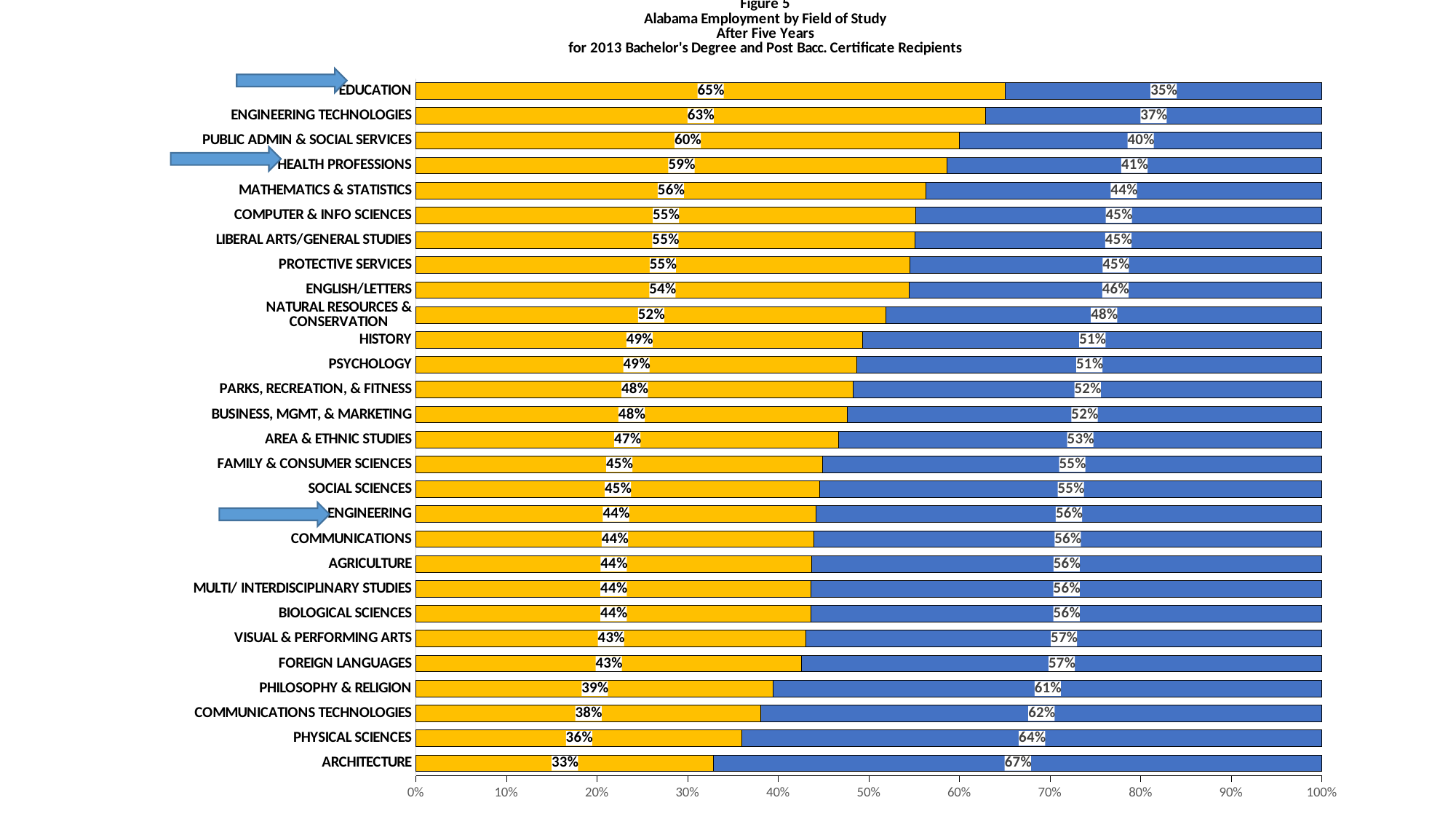
What is the figure number given in the chart title? Figure 5 What is the blue segment value for ENGINEERING? 56% What is the yellow segment value for EDUCATION? 65% How many fields of study are shown on the chart? 28 Which field of study has the smallest yellow segment? ARCHITECTURE What kind of chart is shown on the slide? Stacked bar chart What is the total of the stacked bar for PSYCHOLOGY? 100% Which has a larger yellow segment, PHILOSOPHY & RELIGION or PHYSICAL SCIENCES? PHILOSOPHY & RELIGION What is the yellow segment value for HEALTH PROFESSIONS? 59% What is the difference between the yellow segment values for EDUCATION and ARCHITECTURE? 32 percentage points What is the blue segment value for ARCHITECTURE? 67% Which field of study has the largest yellow segment? EDUCATION